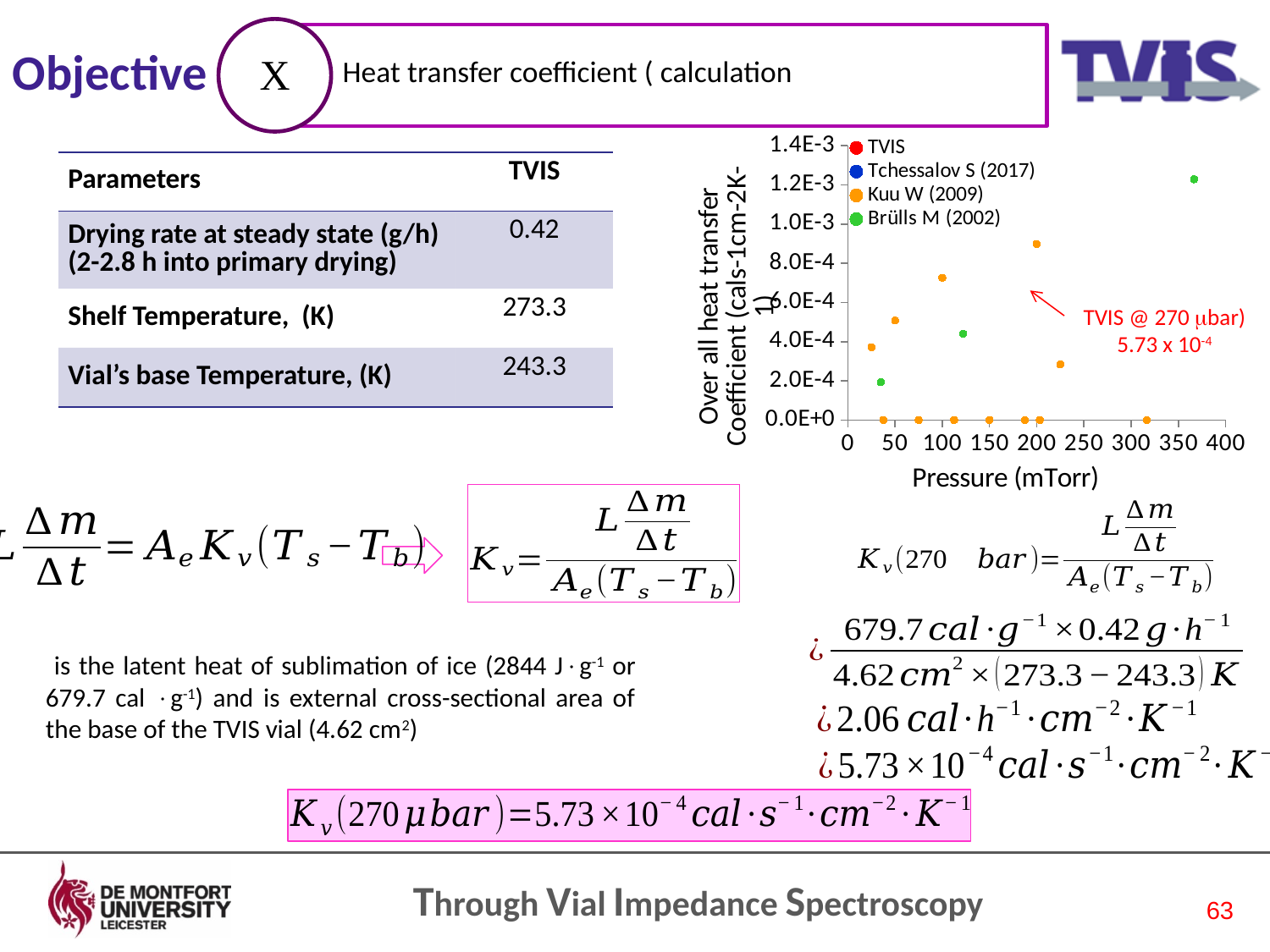
Is the Brülls M (2002) point near 35 mTorr greater or less than 4.0E-4? less How many Brülls M (2002) points are plotted on the chart? 3 Which series are listed in the chart legend? TVIS, Tchessalov S (2017), Kuu W (2009), Brülls M (2002) Is the highest Brülls M (2002) point (near 365 mTorr) greater or less than 1.0E-3? greater What kind of chart is shown on the slide? scatter chart Which series has the highest plotted point on the chart? Brülls M (2002) What heat transfer coefficient value is annotated for TVIS @ 270 μbar on the chart? 5.73 x 10^-4 Is the Kuu W (2009) point near 200 mTorr greater or less than 8.0E-4? greater Do the Brülls M (2002) points rise or fall as pressure increases? rise How many series does the chart legend list? 4 What is the x-axis title of the chart? Pressure (mTorr) Which is larger: the highest Brülls M (2002) point or the highest Kuu W (2009) point? Brülls M (2002)